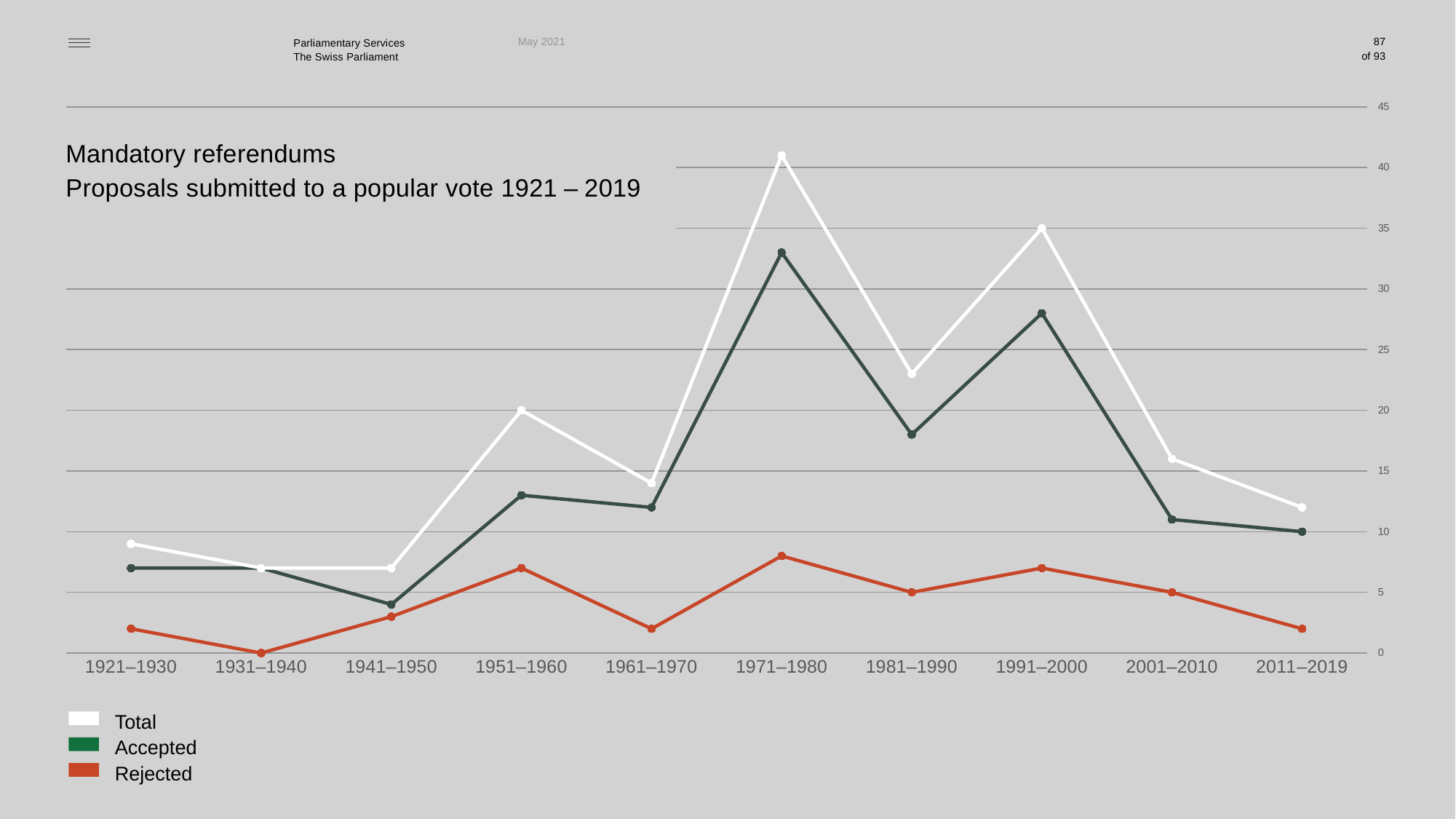
In which period is the Rejected value lowest? 1931–1940 Does the Total line rise or fall from 1991–2000 to 2011–2019? fall In which period is the Total value highest? 1971–1980 How many time periods are shown on the x axis? 10 What is the Rejected value for 1931–1940? 0 What is the Accepted value for 2011–2019? 10 Which is larger in 1971–1980, Accepted or Rejected? Accepted What is the Total value for 1991–2000? 35 What is the Total value for 1951–1960? 20 What kind of chart is shown on the slide? line chart Is the Total value for 1971–1980 greater or less than 40? greater How many series does the legend list? 3